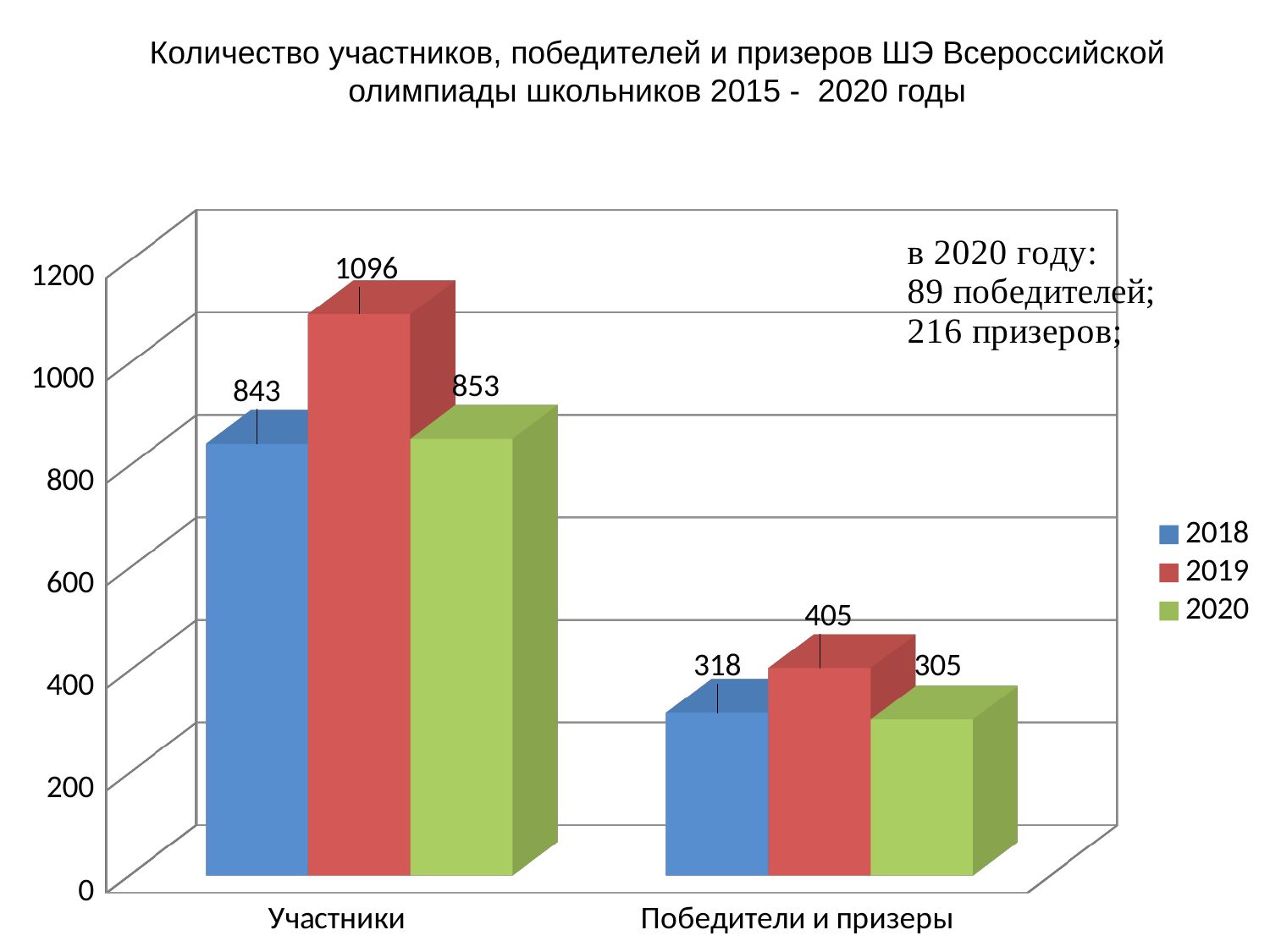
How many categories are shown on the x axis? 2 What is the value for 2019 in the Победители и призеры category? 405 What is the value for 2020 in the Победители и призеры category? 305 Which is larger: the 2020 value for Участники or the 2018 value for Участники? 2020 How many series does the legend list? 3 What is the value for 2018 in the Участники category? 843 Which year has the highest value in the Участники category? 2019 What is the difference between the 2018 and 2020 values in the Победители и призеры category? 13 What kind of chart is shown on the slide? Bar chart What is the difference between the 2019 and 2018 values in the Участники category? 253 What is the value for 2019 in the Участники category? 1096 Which year has the lowest value in the Победители и призеры category? 2020